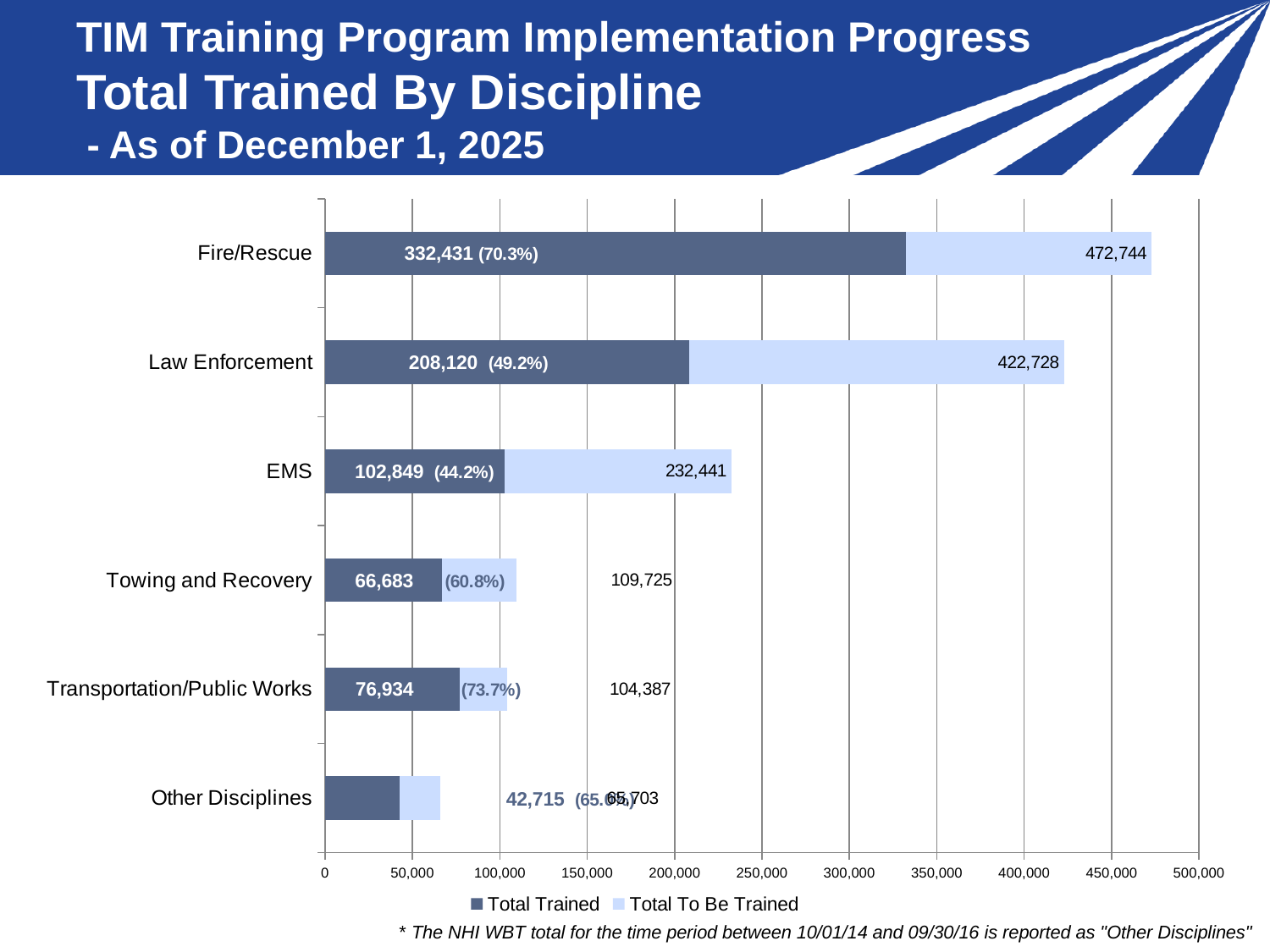
Which discipline has the highest Total Trained value? Fire/Rescue What percentage is shown next to the Total Trained value for Law Enforcement? 49.2% What is the difference between the Total Trained values for Fire/Rescue and Law Enforcement? 124,311 Which has a larger Total Trained value, Towing and Recovery or Transportation/Public Works? Transportation/Public Works How many series does the legend list? 2 What is the Total Trained value for Fire/Rescue? 332,431 Which discipline has the lowest Total Trained value? Other Disciplines What kind of chart is shown on the slide? Stacked bar chart What is the total of the stacked bar for EMS? 232,441 How many disciplines are shown on the chart? 6 What are the two series named in the legend? Total Trained and Total To Be Trained Is the full stacked bar for Law Enforcement greater or less than 400,000? greater